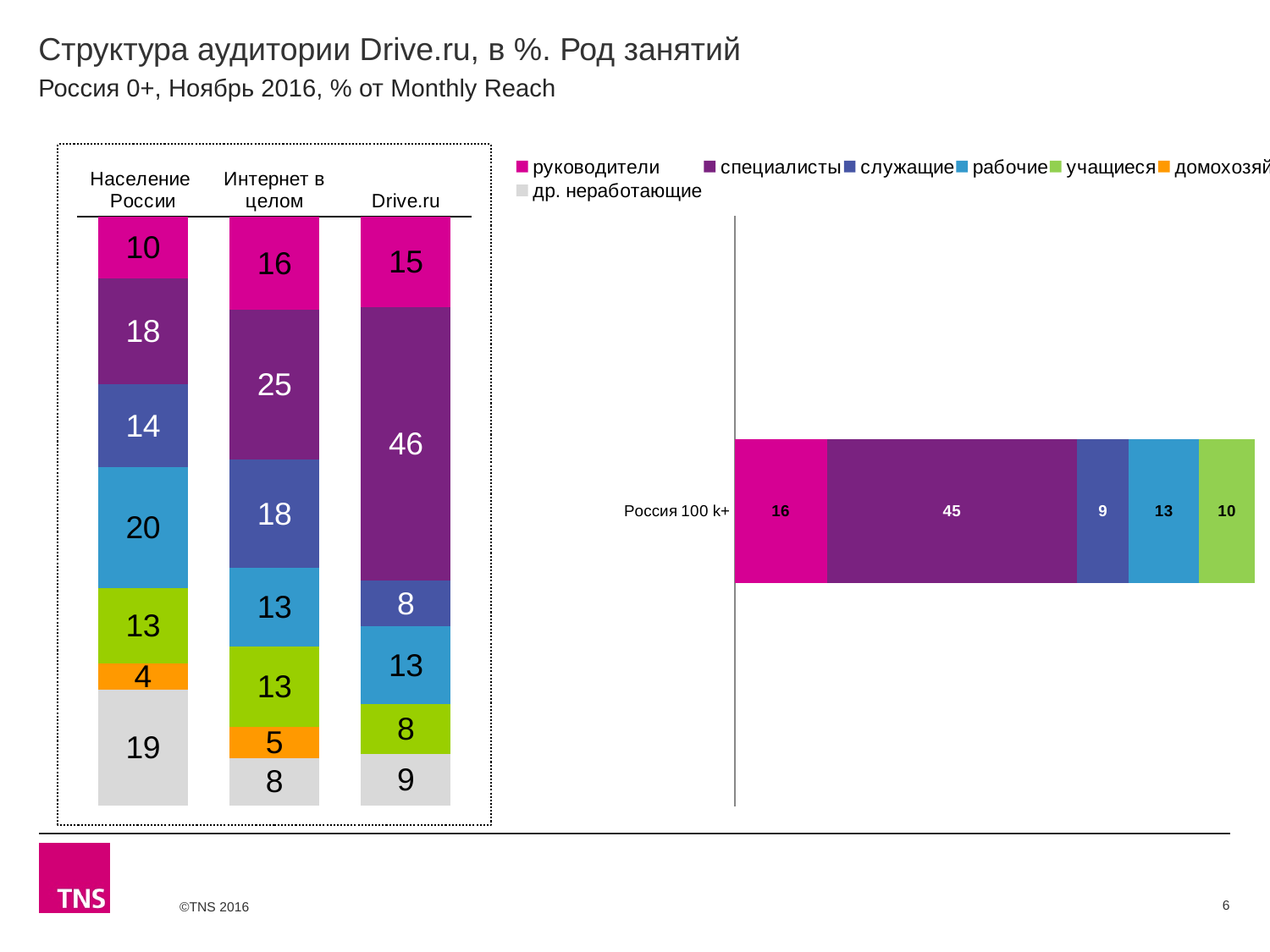
What type of chart is the right chart? Stacked bar chart In the left chart, which of the three bars has the smallest др. неработающие (grey) segment? Интернет в целом In the left chart, which is larger: the рабочие value for Население России or for Drive.ru? Население России In the left chart, what is the value of the специалисты (purple) segment for Drive.ru? 46 How many series does the legend list? 7 How many bars (categories) are shown in the left chart? 3 In the left chart, what is the difference between the специалисты value for Drive.ru and for Интернет в целом? 21 In the right chart, what is the value of the специалисты (purple) segment for Россия 100 k+? 45 In the left chart, what is the value of the руководители (pink) segment for Население России? 10 In the left chart, what is the value of the др. неработающие (grey) segment for Интернет в целом? 8 In the left chart, which of the three bars has the largest специалисты (purple) segment? Drive.ru In the right chart, what is the value of the рабочие (light blue) segment for Россия 100 k+? 13